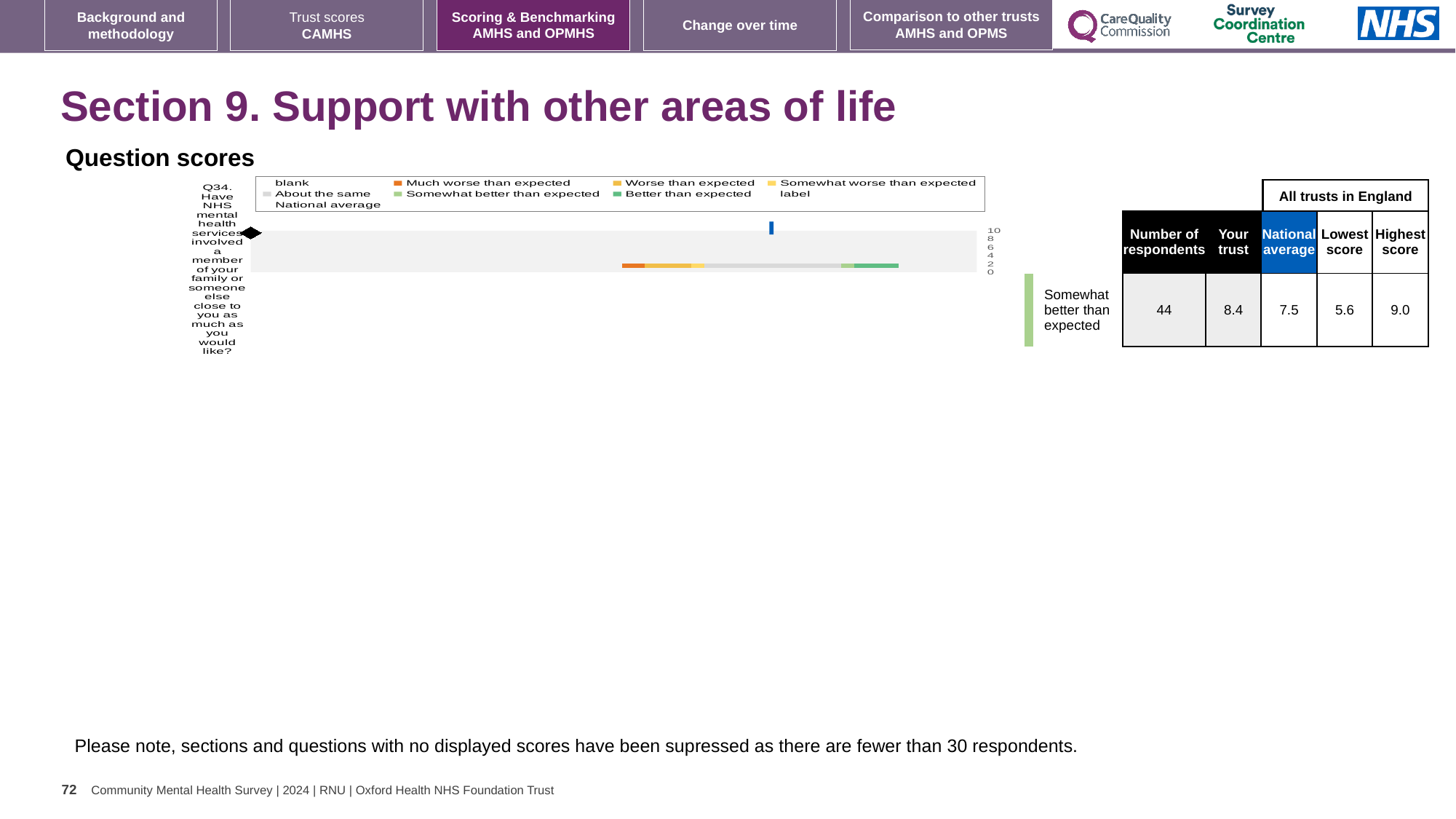
Which question number is plotted in the question scores chart? Q34 What is the 'Your trust' score for Q34? 8.4 What is the highest value shown on the score axis of the question scores chart? 10 How many respondents answered Q34? 44 What is the highest score among all trusts in England for Q34? 9.0 Which is larger for Q34, the 'Your trust' score or the national average? Your trust What is the national average score for Q34? 7.5 How many questions are plotted in the question scores chart? 1 What kind of chart is used to show the question scores on this slide? bar chart What is the difference between the highest and lowest scores among all trusts in England for Q34? 3.4 What is the lowest score among all trusts in England for Q34? 5.6 What is the difference between the 'Your trust' score and the national average for Q34? 0.9